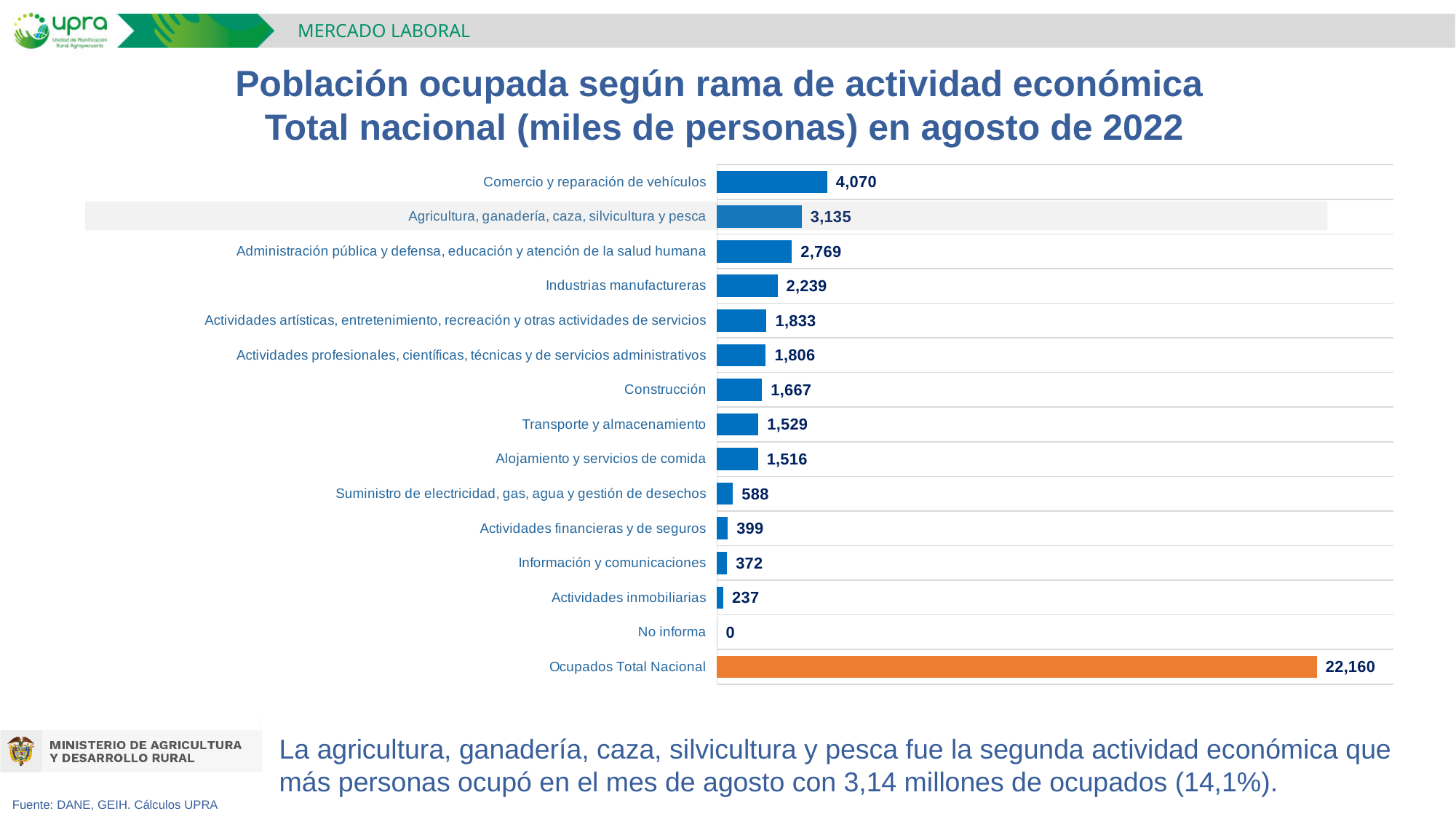
Which category has the lowest value? No informa What kind of chart is shown on the slide? Bar chart Which is larger, Construcción or Transporte y almacenamiento? Construcción What is the difference between Comercio y reparación de vehículos and Agricultura, ganadería, caza, silvicultura y pesca? 935 What is the value for Suministro de electricidad, gas, agua y gestión de desechos? 588 What is the value for Comercio y reparación de vehículos? 4,070 What is the difference between Actividades financieras y de seguros and Información y comunicaciones? 27 What is the value for Ocupados Total Nacional? 22,160 How many categories are shown in the chart? 15 Which bar is shown in orange rather than blue? Ocupados Total Nacional What is the value for Agricultura, ganadería, caza, silvicultura y pesca? 3,135 Excluding the Ocupados Total Nacional bar, which category has the highest value? Comercio y reparación de vehículos